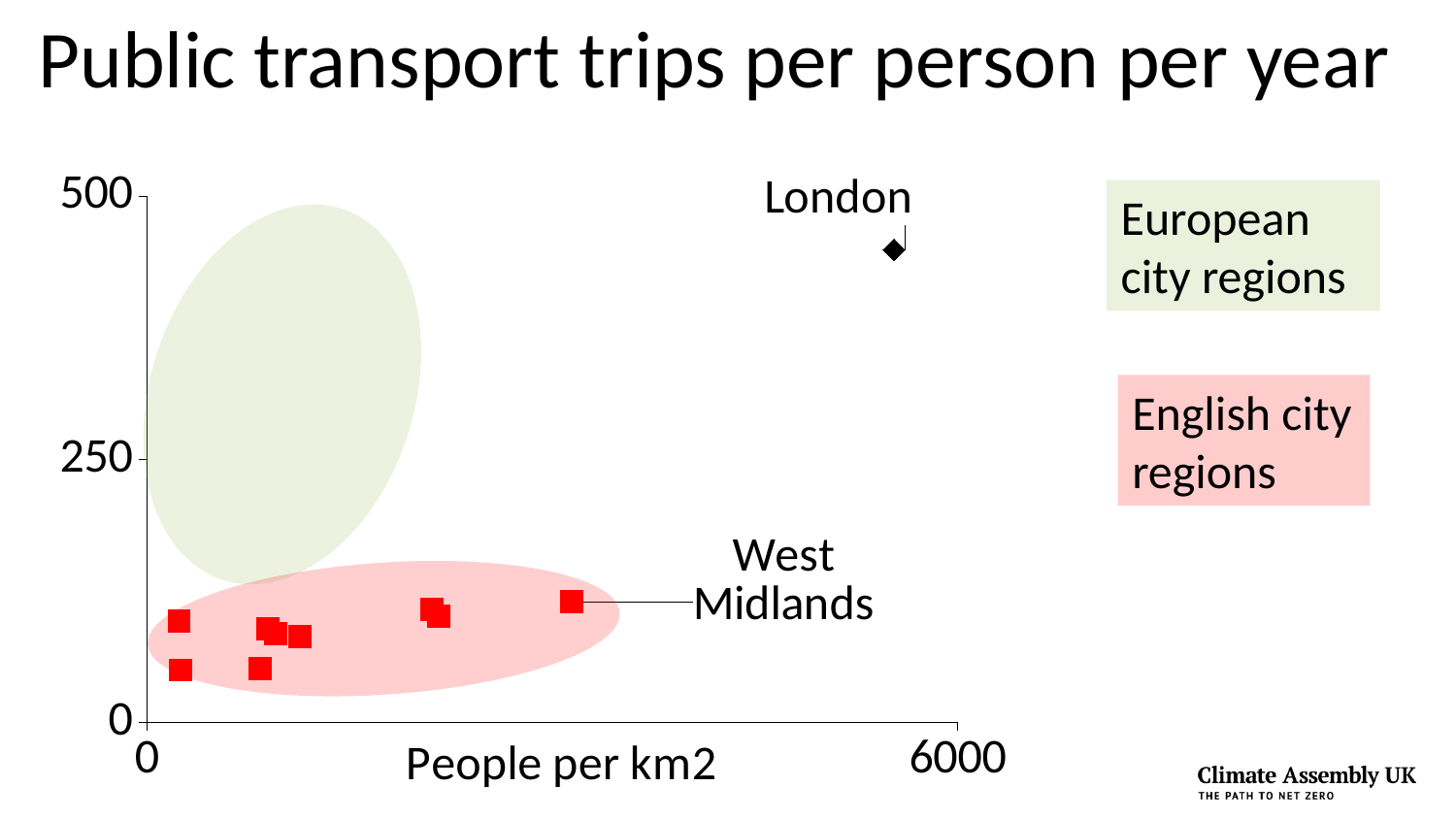
Is the value for London greater or less than 250 trips per person per year? greater What kind of chart is shown on the slide? scatter chart Which labelled city region has the lowest number of public transport trips per person per year? West Midlands What is the label of the x axis? People per km2 What is the highest value shown on the x axis? 6000 What is the title of the chart? Public transport trips per person per year Which labelled city region has the highest number of public transport trips per person per year? London What is the highest value shown on the y axis? 500 Is the value for London greater or less than 500 trips per person per year? less Is the value for West Midlands greater or less than 250 trips per person per year? less Which has more public transport trips per person per year, London or West Midlands? London How many data points on the chart are labelled by name? 2